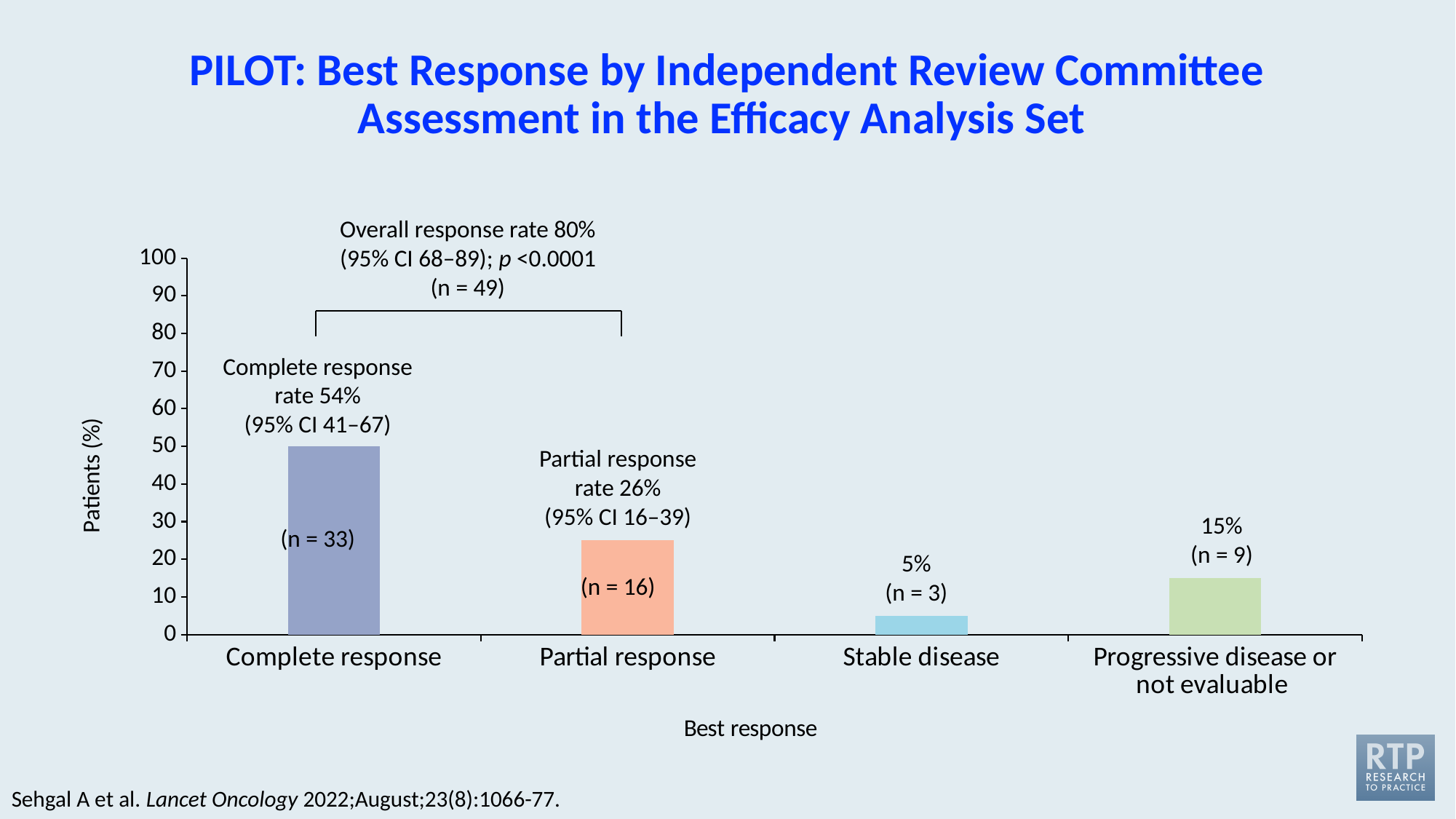
What percentage of patients had stable disease? 5% What is the partial response rate shown on the chart? 26% Which is larger, the percentage for stable disease or for progressive disease or not evaluable? Progressive disease or not evaluable What percentage of patients had progressive disease or were not evaluable? 15% How many patients had a partial response (n)? 16 What is the difference in percentage points between the complete response rate and the partial response rate? 28 What is the overall response rate stated above the bracket? 80% How many best response categories are shown on the x axis? 4 What type of chart is shown on the slide? Bar chart What is the complete response rate shown on the chart? 54% Which best response category has the lowest percentage of patients? Stable disease Which best response category has the highest percentage of patients? Complete response